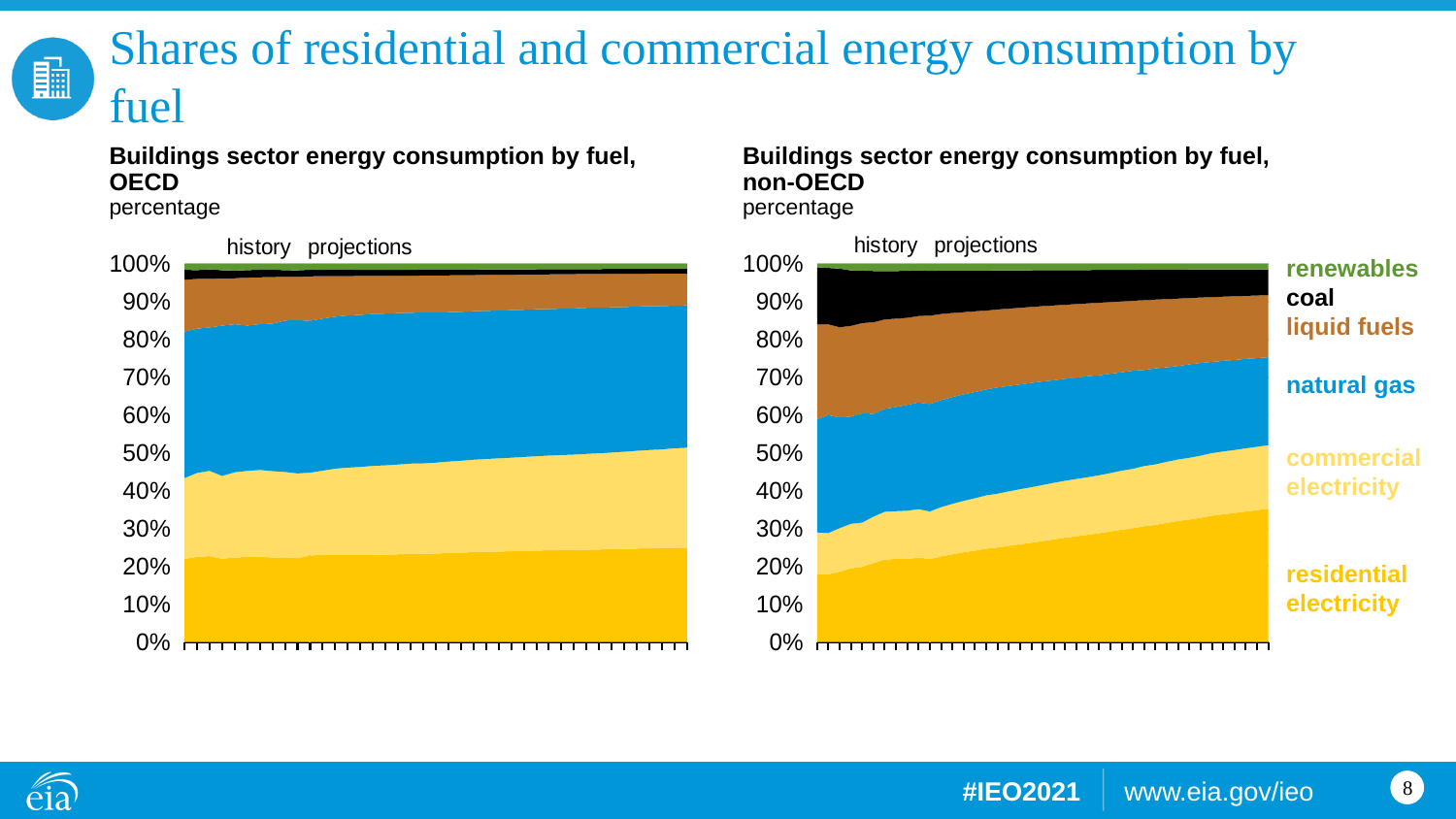
In the non-OECD chart, does the share of coal rise or fall from left to right along the x axis? fall What kind of chart is the left chart, 'Buildings sector energy consumption by fuel, OECD'? stacked area chart In the non-OECD chart, is the share of residential electricity at the right edge of the projections period greater or less than 30%? greater In the OECD chart, which is larger at the left edge of the history period: the share of natural gas or the share of commercial electricity? natural gas In the legend, which fuel is shown in black? coal How many fuel series does the legend on the right of the slide list? 6 What unit is shown beneath the title of each chart? percentage In the OECD chart, which fuel accounts for the largest share of buildings sector energy consumption? natural gas In the OECD chart, is the share of residential electricity at the left edge of the history period greater or less than 30%? less In the OECD chart, is the share of natural gas at the left edge of the history period greater or less than 30%? greater In the non-OECD chart, does the share of residential electricity rise or fall from left to right along the x axis? rise What is the title of the right chart? Buildings sector energy consumption by fuel, non-OECD